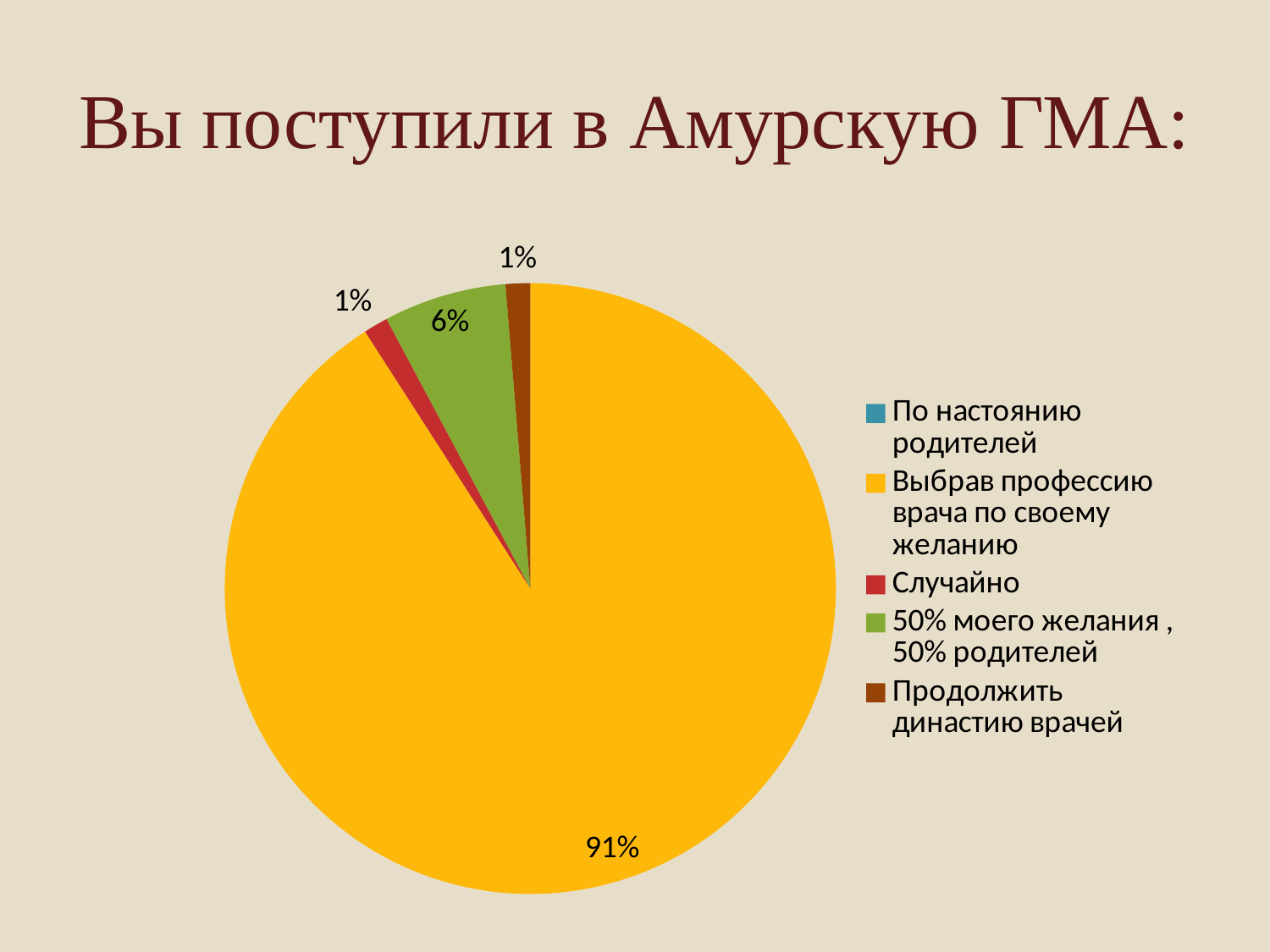
What is the title of the slide? Вы поступили в Амурскую ГМА: How many slices with data labels are visible in the pie? 4 What percentage is shown for "Продолжить династию врачей"? 1% What percentage is shown for "Случайно"? 1% What share of the pie is labelled for "Выбрав профессию врача по своему желанию"? 91% What colour is the largest slice of the pie? yellow How many entries does the legend list? 5 Which is larger: the slice for "50% моего желания, 50% родителей" or the slice for "Случайно"? 50% моего желания, 50% родителей What kind of chart is shown on the slide? pie chart What percentage is shown for "50% моего желания, 50% родителей"? 6% Which category has the largest slice of the pie? Выбрав профессию врача по своему желанию What is the difference in percentage points between "Выбрав профессию врача по своему желанию" and "50% моего желания, 50% родителей"? 85